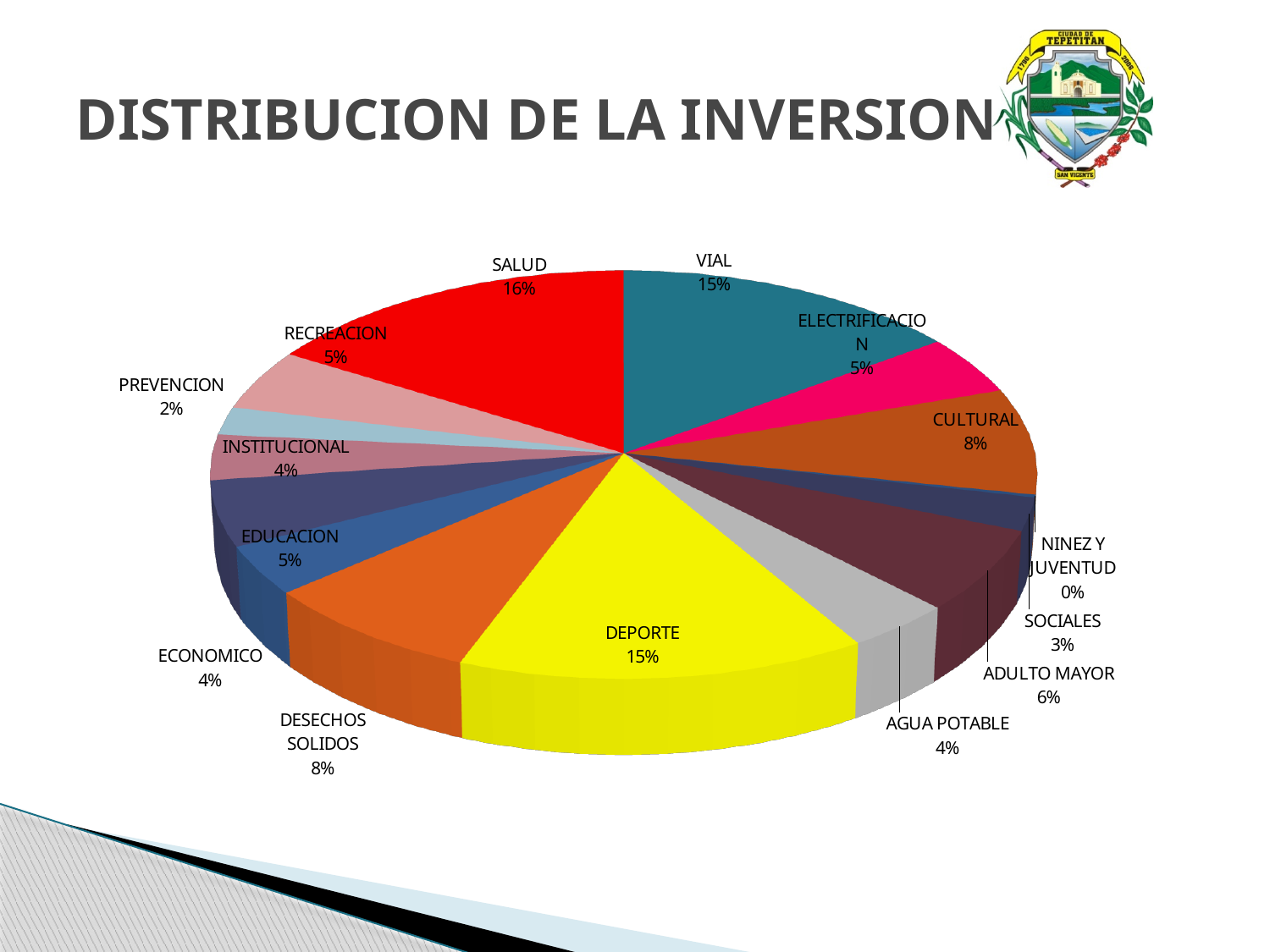
Which is larger, the share for CULTURAL or the share for SOCIALES? CULTURAL Which category has the smallest share of the investment? NINEZ Y JUVENTUD What share does CULTURAL receive? 8% What kind of chart is shown on the slide? Pie chart Which category has the largest share of the investment? SALUD How many categories are shown in the pie chart? 15 What percentage is shown for ADULTO MAYOR? 6% What percentage is shown for DEPORTE? 15% What is the combined share of VIAL and DEPORTE? 30% What share of the investment goes to SALUD? 16% What is the difference in percentage points between SALUD and PREVENCION? 14 What is the title of the slide? DISTRIBUCION DE LA INVERSION